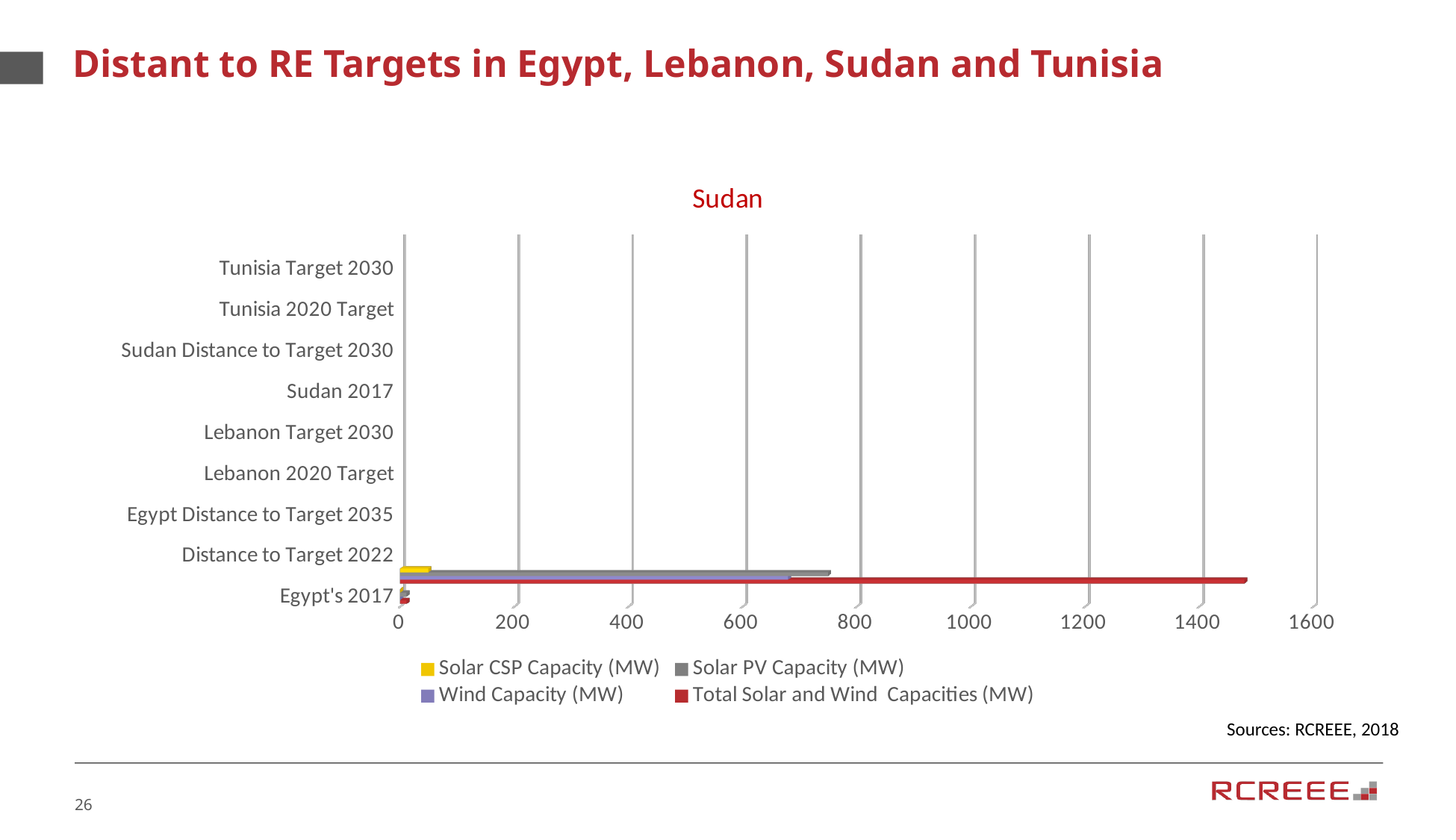
What kind of chart is shown on the slide? bar chart Is the longest yellow bar (Solar CSP Capacity) greater or less than 200? less Is the longest red bar (Total Solar and Wind Capacities) greater or less than 1400? greater Which series is shown in red in the chart legend? Total Solar and Wind Capacities (MW) Is the longest purple bar (Wind Capacity) greater or less than 600? greater How many categories are listed on the vertical axis of the chart? 9 How many series does the chart legend list? 4 Which is longer, the longest red bar (Total Solar and Wind Capacities) or the longest grey bar (Solar PV Capacity)? the red bar (Total Solar and Wind Capacities) What is the maximum value shown on the horizontal axis of the chart? 1600 What is the title of the chart? Sudan